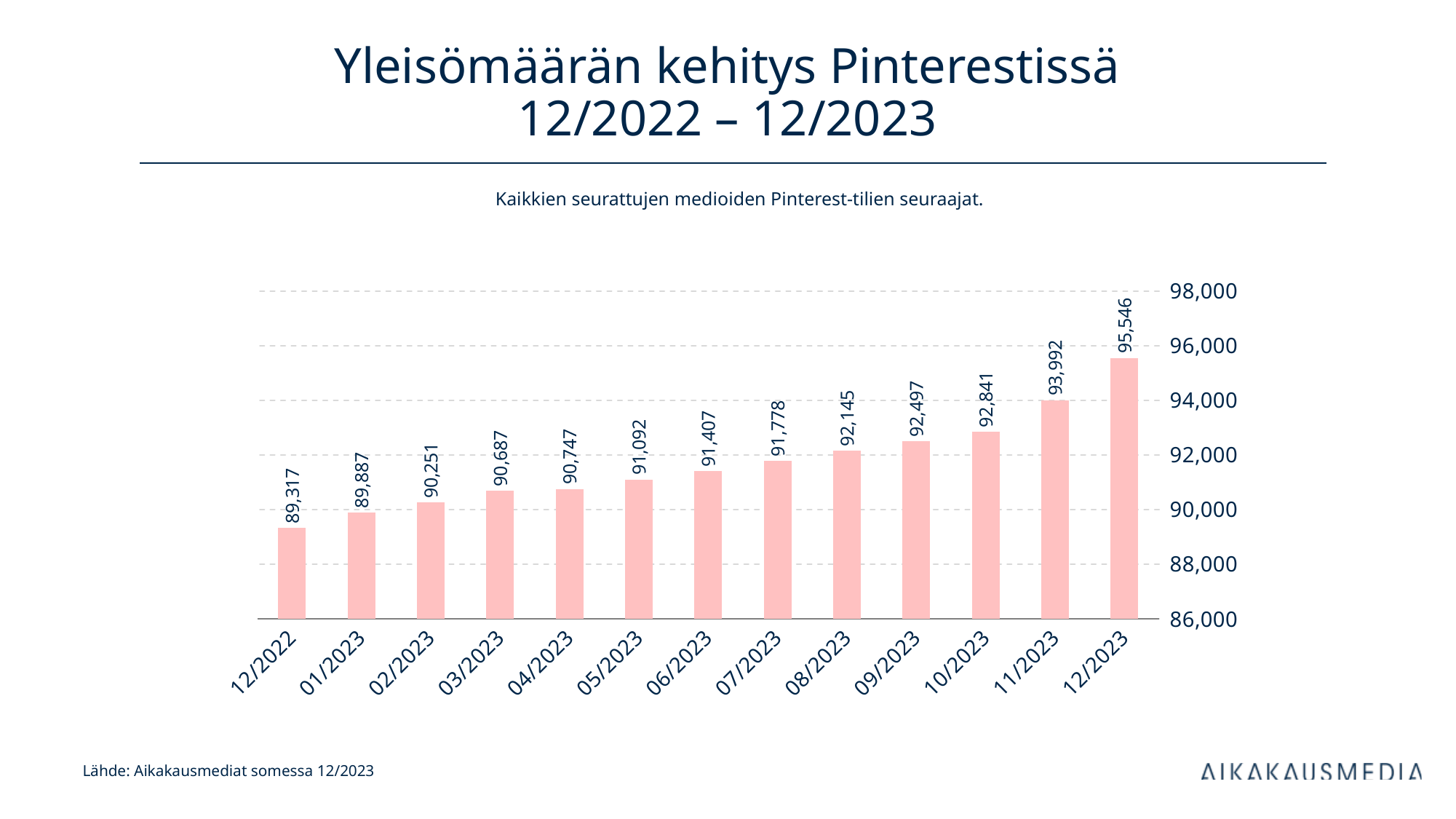
Which month has the lowest value? 12/2022 Which month has the highest value? 12/2023 What is the value for 12/2022? 89,317 What kind of chart is shown on the slide? bar chart How many months are shown on the x axis? 13 What is the value for 11/2023? 93,992 Is the value for 12/2023 greater or less than 94,000? greater What is the difference between the values for 12/2023 and 12/2022? 6,229 Do the values rise or fall from 12/2022 to 12/2023? rise Which is larger, the value for 03/2023 or the value for 09/2023? 09/2023 What is the value for 06/2023? 91,407 What is the difference between the values for 11/2023 and 10/2023? 1,151